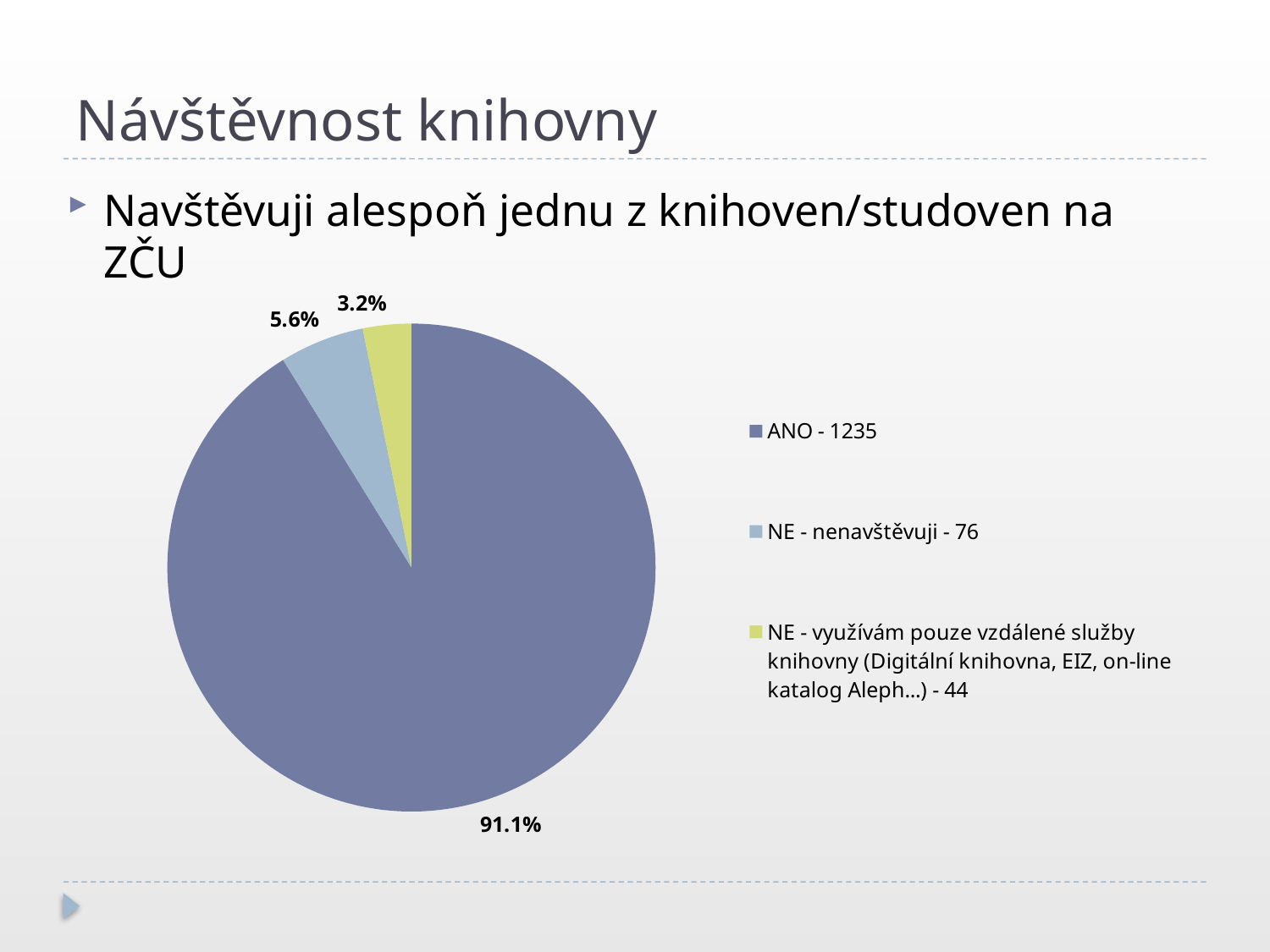
What share of the pie does the "ANO" slice take? 91.1% What percentage is shown for the slice labelled "NE - využívám pouze vzdálené služby knihovny (Digitální knihovna, EIZ, on-line katalog Aleph...) - 44"? 3.2% What colour is the slice representing "ANO - 1235"? blue-grey (dark blue) How many entries does the legend of the pie chart list? 3 What is the difference in percentage points between the "NE - nenavštěvuji - 76" slice and the "NE - využívám pouze vzdálené služby knihovny" slice? 2.4 How many slices does the pie chart have? 3 What percentage is shown for the slice labelled "ANO - 1235"? 91.1% What percentage is shown for the slice labelled "NE - nenavštěvuji - 76"? 5.6% Which slice is larger: "NE - nenavštěvuji - 76" or "NE - využívám pouze vzdálené služby knihovny ... - 44"? NE - nenavštěvuji - 76 Which slice of the pie chart is the smallest? NE - využívám pouze vzdálené služby knihovny (Digitální knihovna, EIZ, on-line katalog Aleph...) - 44 Which slice of the pie chart is the largest? ANO - 1235 What kind of chart is shown on the slide? pie chart